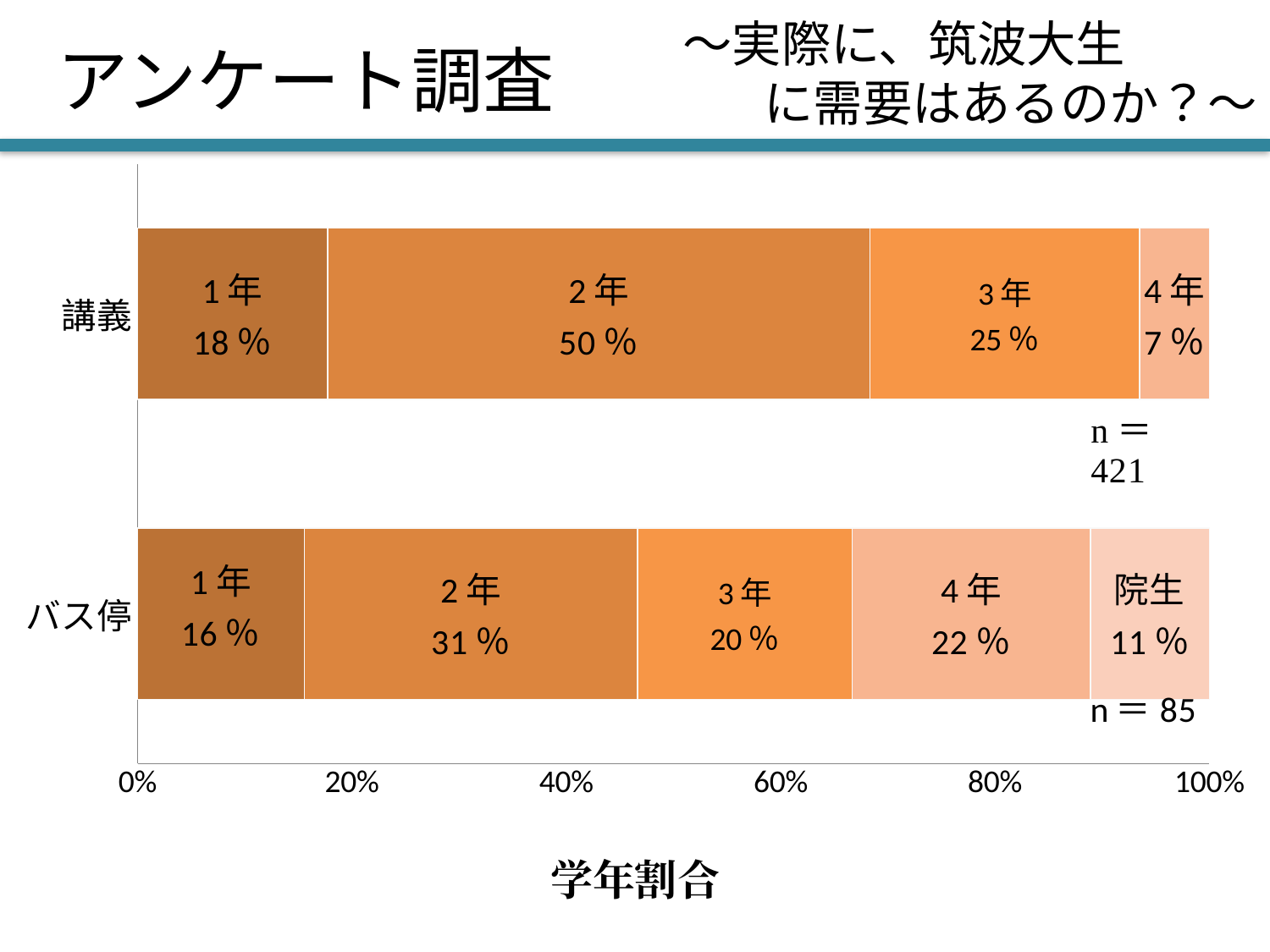
What percentage of the 講義 respondents are 4年? 7 % Which year group has the largest share in the バス停 bar? 2年 How many segments make up the バス停 bar? 5 Which year group has the smallest share in the 講義 bar? 4年 Which is larger: the 3年 share in the 講義 bar or the 3年 share in the バス停 bar? 講義 What is the difference between the 2年 share in the 講義 bar and the 2年 share in the バス停 bar? 19 % What percentage of the 講義 respondents are 2年? 50 % What is the sample size (n) for the 講義 survey? 421 How many bars are shown in the chart? 2 What percentage of the バス停 respondents are 院生? 11 % What is the title shown below the x axis of the chart? 学年割合 What kind of chart is shown on the slide? Stacked bar chart